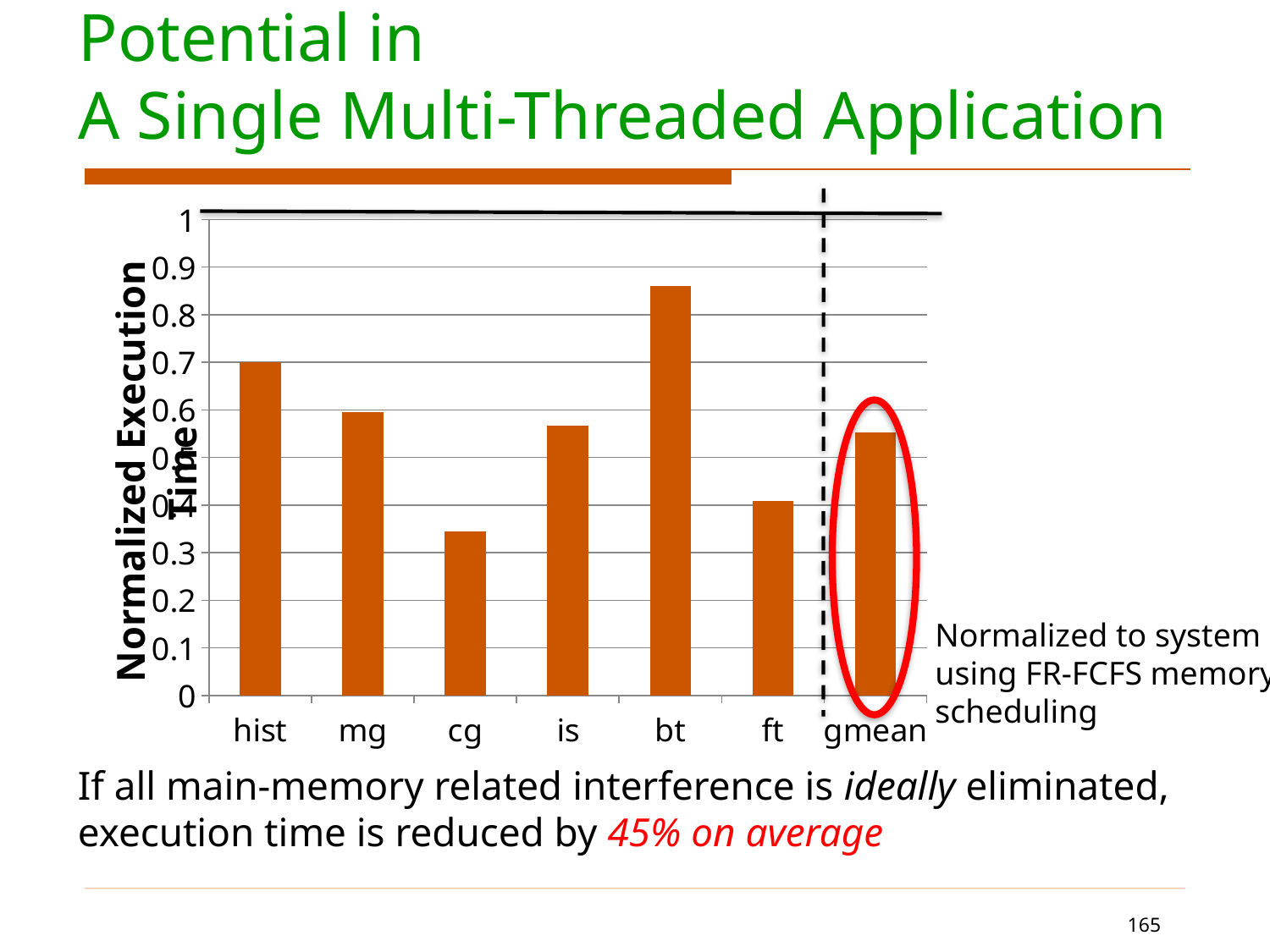
Is the value for gmean greater or less than 0.6? less Which category has the highest normalized execution time? bt Is the value for bt greater or less than 0.8? greater What is the label of the y axis? Normalized Execution Time Is the value for cg greater or less than 0.4? less Which has a higher normalized execution time, hist or mg? hist Which has a higher normalized execution time, bt or ft? bt Which category has the lowest normalized execution time? cg Which category's bar is circled in red on the chart? gmean What kind of chart is shown on the slide? bar chart How many categories are shown on the x axis of the chart? 7